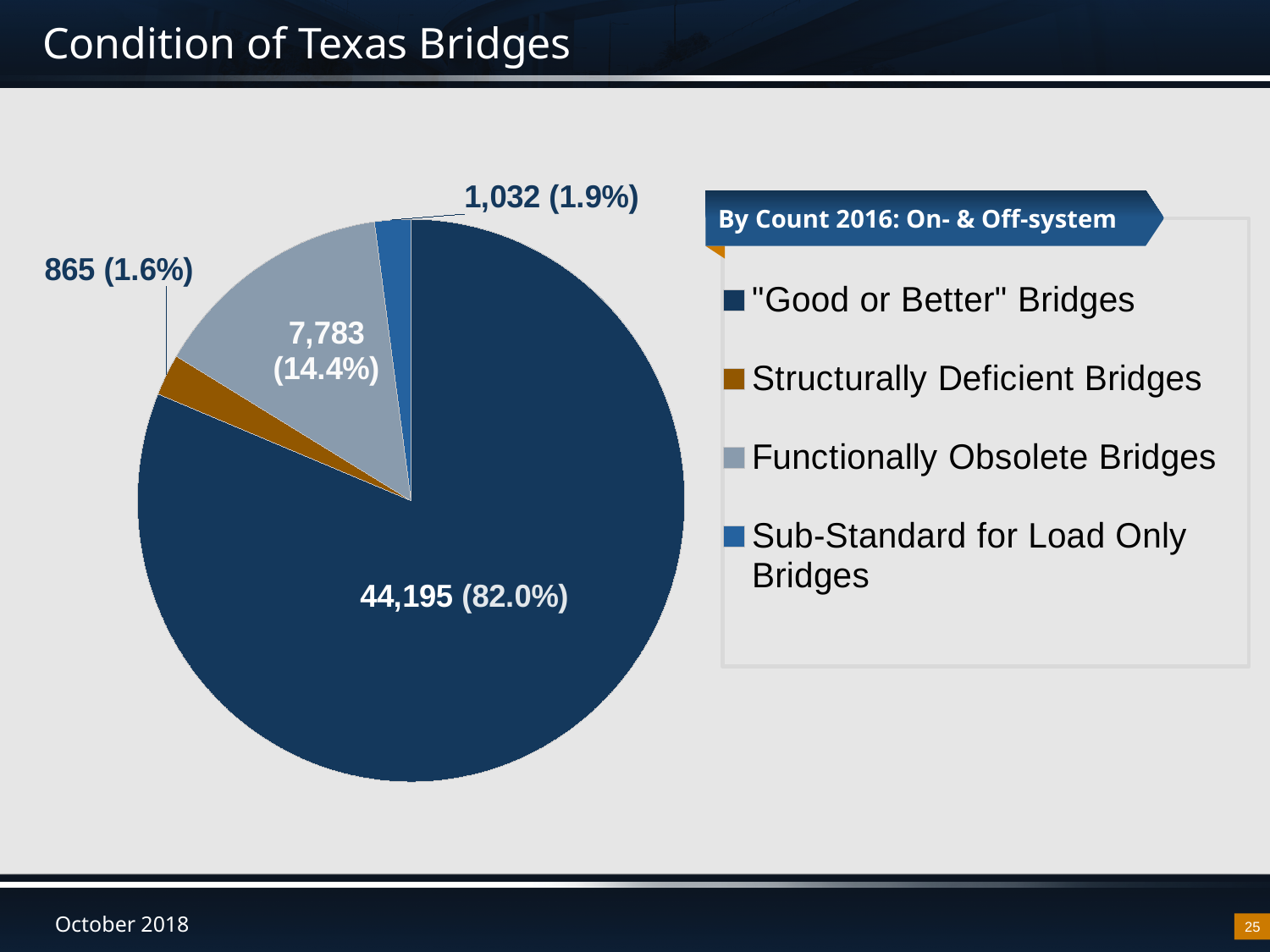
Which category has the smallest slice of the pie? Structurally Deficient Bridges How many Functionally Obsolete Bridges are shown? 7,783 What is the title shown in the legend box of the chart? By Count 2016: On- & Off-system How many bridges are counted as "Good or Better" Bridges? 44,195 How many categories does the pie chart have? 4 What kind of chart is shown on the slide? Pie chart How many Sub-Standard for Load Only Bridges are shown? 1,032 What share of the pie do Functionally Obsolete Bridges represent? 14.4% How many Structurally Deficient Bridges are shown? 865 Which category has the largest slice of the pie? "Good or Better" Bridges What is the difference in count between Sub-Standard for Load Only Bridges and Structurally Deficient Bridges? 167 What share of the pie do "Good or Better" Bridges represent? 82.0%